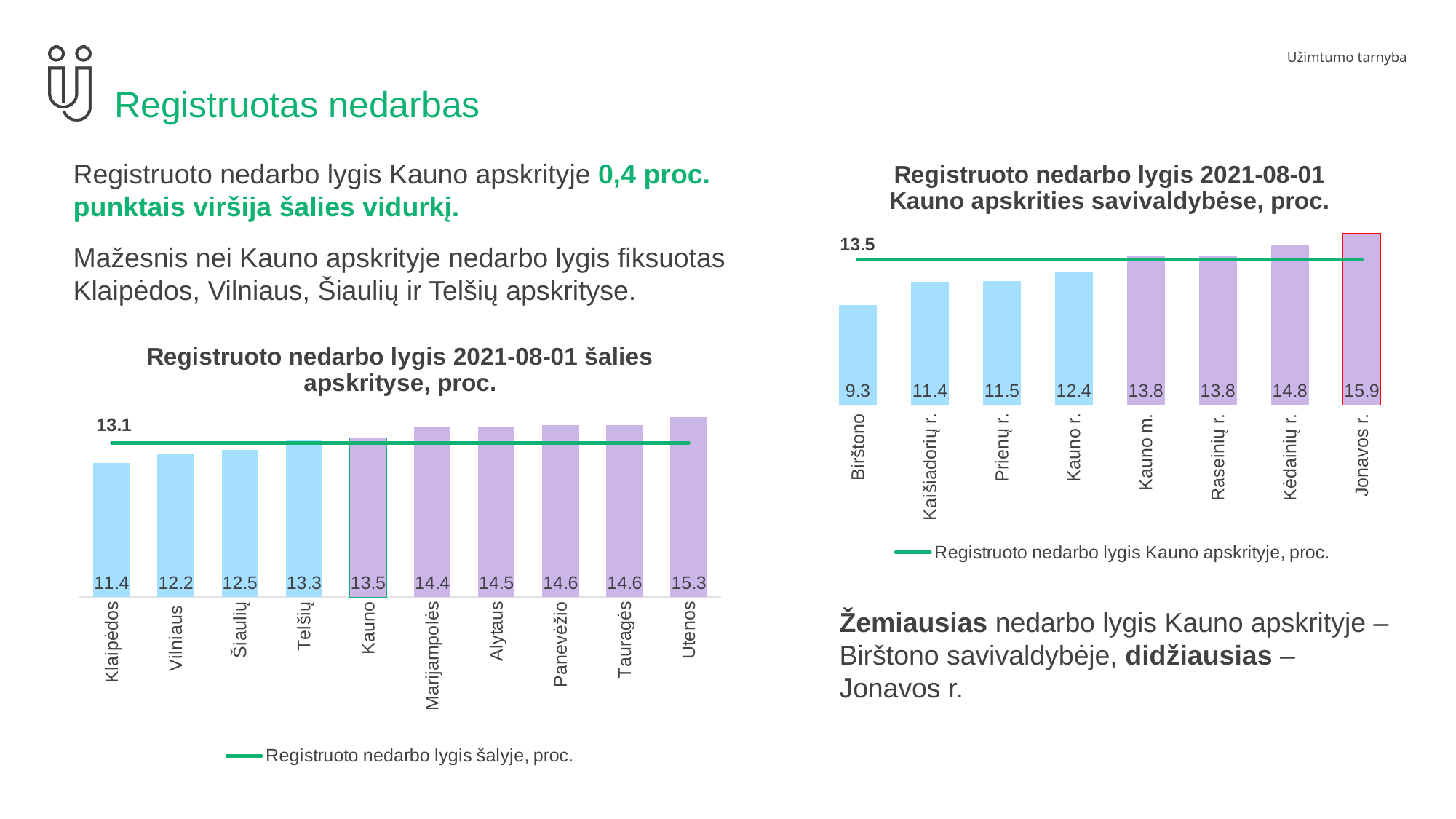
In the chart 'Registruoto nedarbo lygis 2021-08-01 šalies apskrityse, proc.', how many counties are shown? 10 In the chart 'Registruoto nedarbo lygis 2021-08-01 Kauno apskrities savivaldybėse, proc.', what is the value for Jonavos r.? 15.9 In the chart 'Registruoto nedarbo lygis 2021-08-01 šalies apskrityse, proc.', which county has the lowest value? Klaipėdos In the chart 'Registruoto nedarbo lygis 2021-08-01 šalies apskrityse, proc.', what is the value for Kauno? 13.5 What type of chart is 'Registruoto nedarbo lygis 2021-08-01 Kauno apskrities savivaldybėse, proc.'? Bar chart In the chart 'Registruoto nedarbo lygis 2021-08-01 šalies apskrityse, proc.', what value is labelled on the green line for the national level? 13.1 In the chart 'Registruoto nedarbo lygis 2021-08-01 Kauno apskrities savivaldybėse, proc.', which municipality has the lowest value? Birštono In the chart 'Registruoto nedarbo lygis 2021-08-01 Kauno apskrities savivaldybėse, proc.', what is the difference between Jonavos r. and Birštono? 6.6 In the chart 'Registruoto nedarbo lygis 2021-08-01 šalies apskrityse, proc.', which county has the highest value? Utenos In the chart 'Registruoto nedarbo lygis 2021-08-01 Kauno apskrities savivaldybėse, proc.', which is larger, Kauno r. or Kėdainių r.? Kėdainių r. In the chart 'Registruoto nedarbo lygis 2021-08-01 Kauno apskrities savivaldybėse, proc.', how many municipalities are shown? 8 In the chart 'Registruoto nedarbo lygis 2021-08-01 šalies apskrityse, proc.', what is the difference between Utenos and Klaipėdos? 3.9